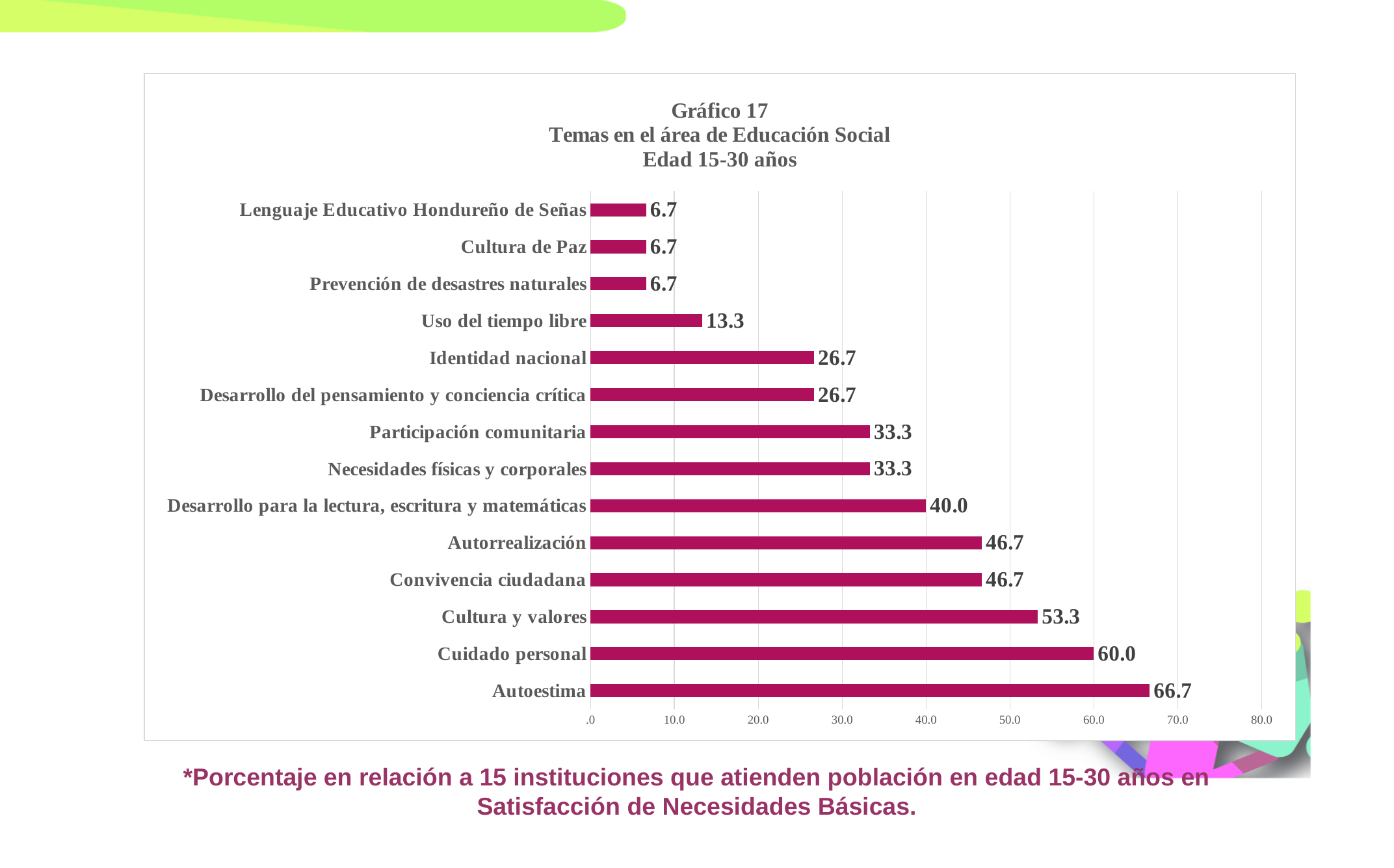
Is the value for Cultura y valores greater or less than 50.0? greater What is the difference between the values for Autoestima and Identidad nacional? 40.0 Which category has the highest value? Autoestima What is the value for Autoestima? 66.7 What is the difference between the values for Cuidado personal and Cultura y valores? 6.7 Which is larger, the value for Participación comunitaria or the value for Autorrealización? Autorrealización What kind of chart is shown on the slide? Bar chart How many categories are shown in the chart? 14 What is the value for Desarrollo para la lectura, escritura y matemáticas? 40.0 What is the number of the chart given in its title? Gráfico 17 What is the value for Uso del tiempo libre? 13.3 How many categories have a value of 6.7? 3